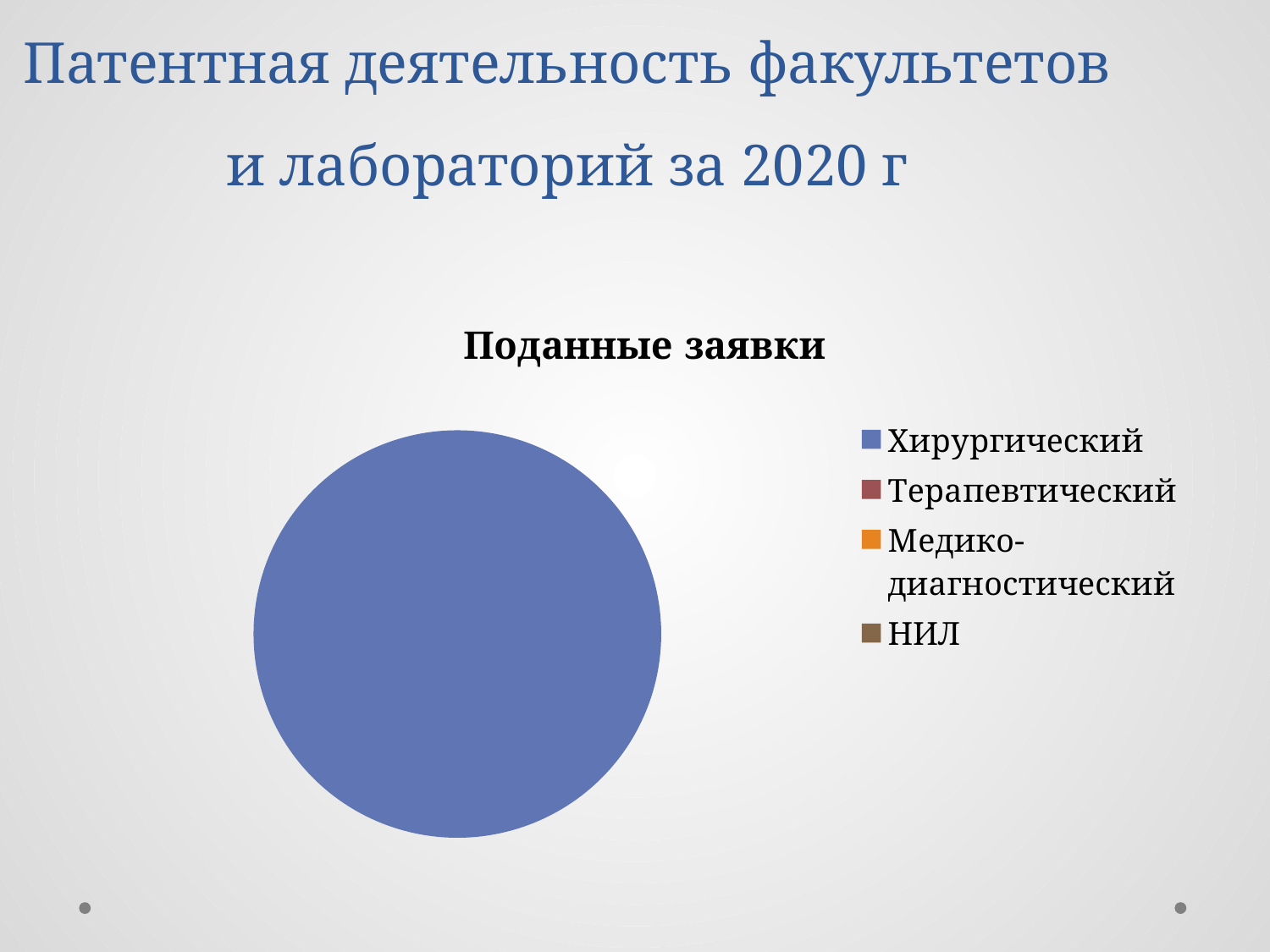
How many categories does the chart's legend list? 4 What kind of chart is shown on the slide? pie chart Which is larger in the pie: Хирургический or НИЛ? Хирургический Which is larger in the pie: Хирургический or Терапевтический? Хирургический Which category accounts for the largest share of the pie? Хирургический Which category is shown in blue in the legend? Хирургический What is the title of the chart? Поданные заявки